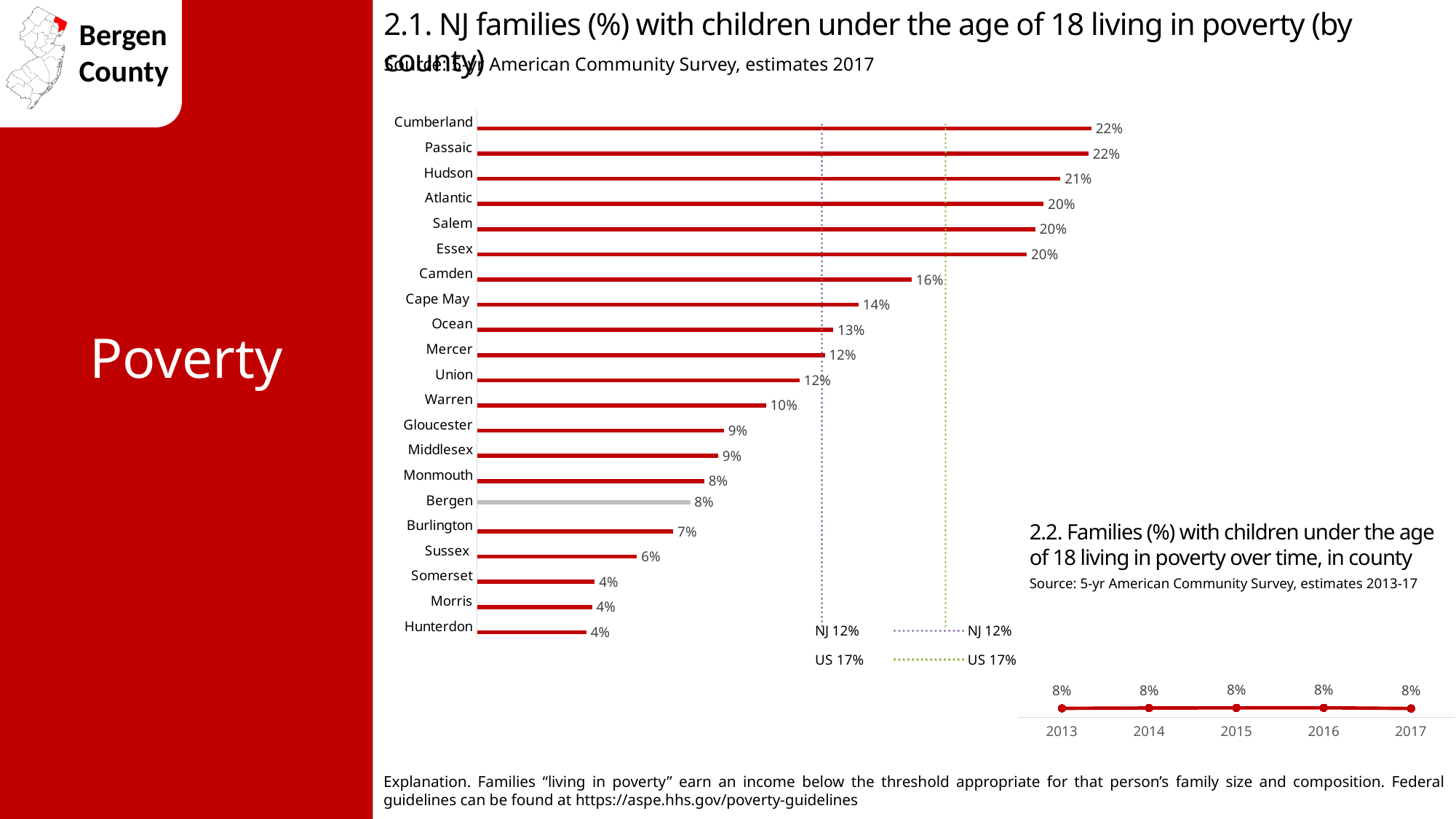
In chart 2.2, how many years are plotted? 5 In chart 2.1, what is the US reference value marked by the dotted line? US 17% What kind of chart is chart 2.1? Bar chart In chart 2.2, do the values rise, fall, or stay flat from 2013 to 2017? Stay flat What kind of chart is chart 2.2? Line chart In chart 2.1, what percentage of families with children under 18 in Bergen County live in poverty? 8% In chart 2.1, what is the NJ reference value marked by the dotted line? NJ 12% In chart 2.1, which has a higher value, Cape May or Warren? Cape May In chart 2.1, what is the value shown for Hudson? 21% In chart 2.1, what is the difference in percentage points between Cumberland and Bergen? 14 percentage points In chart 2.1, what is the value shown for Camden? 16% In chart 2.1, how many counties are listed on the vertical axis? 21